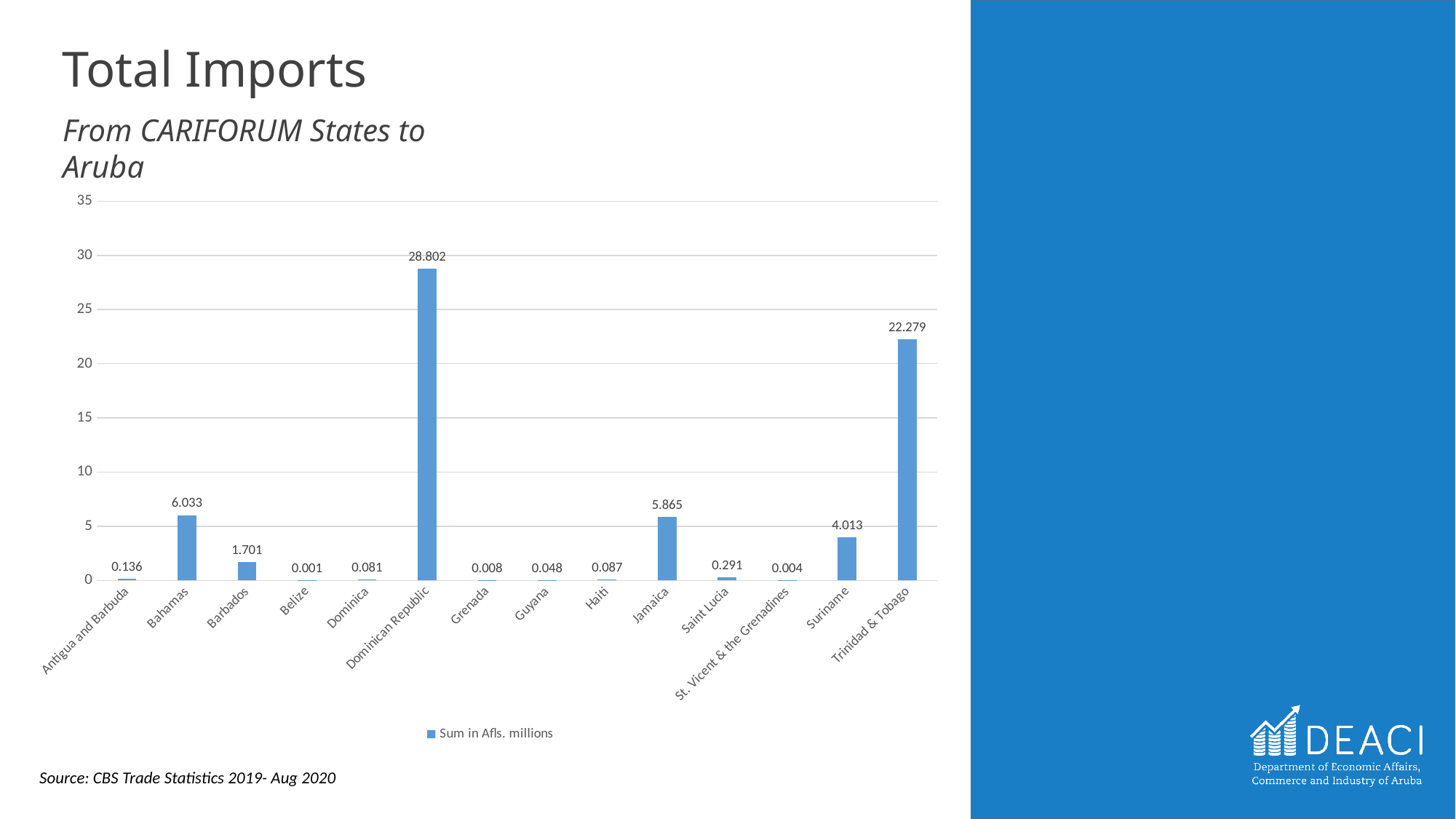
What is the value for Suriname? 4.013 How many countries are shown on the x axis? 14 What is the difference between the values for Bahamas and Barbados? 4.332 What is the value for Trinidad & Tobago? 22.279 Which is larger, the value for Bahamas or the value for Suriname? Bahamas What is the value for Saint Lucia? 0.291 What is the legend entry for the series shown? Sum in Afls. millions What is the difference between the values for the Dominican Republic and Trinidad & Tobago? 6.523 Which country has the lowest value? Belize What kind of chart is shown on the slide? Bar chart Which country has the highest value? Dominican Republic What is the value for the Dominican Republic? 28.802